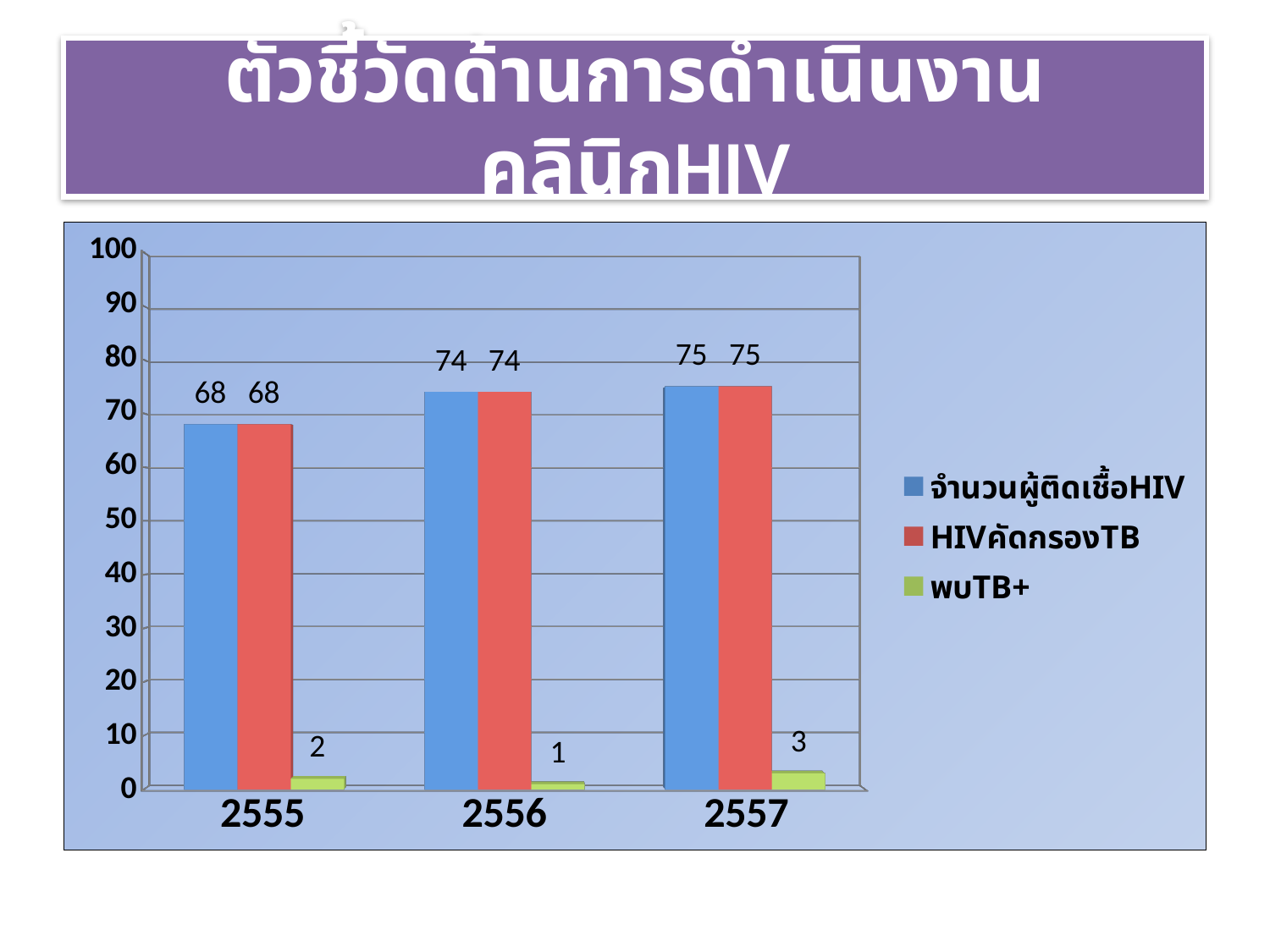
Does จำนวนผู้ติดเชื้อHIV rise or fall from 2555 to 2557? rise Which is larger: พบTB+ in 2555 or พบTB+ in 2557? 2557 What is the value for จำนวนผู้ติดเชื้อHIV in 2555? 68 What is the difference between จำนวนผู้ติดเชื้อHIV in 2557 and in 2555? 7 In which year is จำนวนผู้ติดเชื้อHIV highest? 2557 How many years are shown on the x axis? 3 What is the value for พบTB+ in 2556? 1 In which year is พบTB+ lowest? 2556 What kind of chart is shown on the slide? bar chart What is the value for HIVคัดกรองTB in 2556? 74 How many series does the legend list? 3 What is the value for พบTB+ in 2557? 3